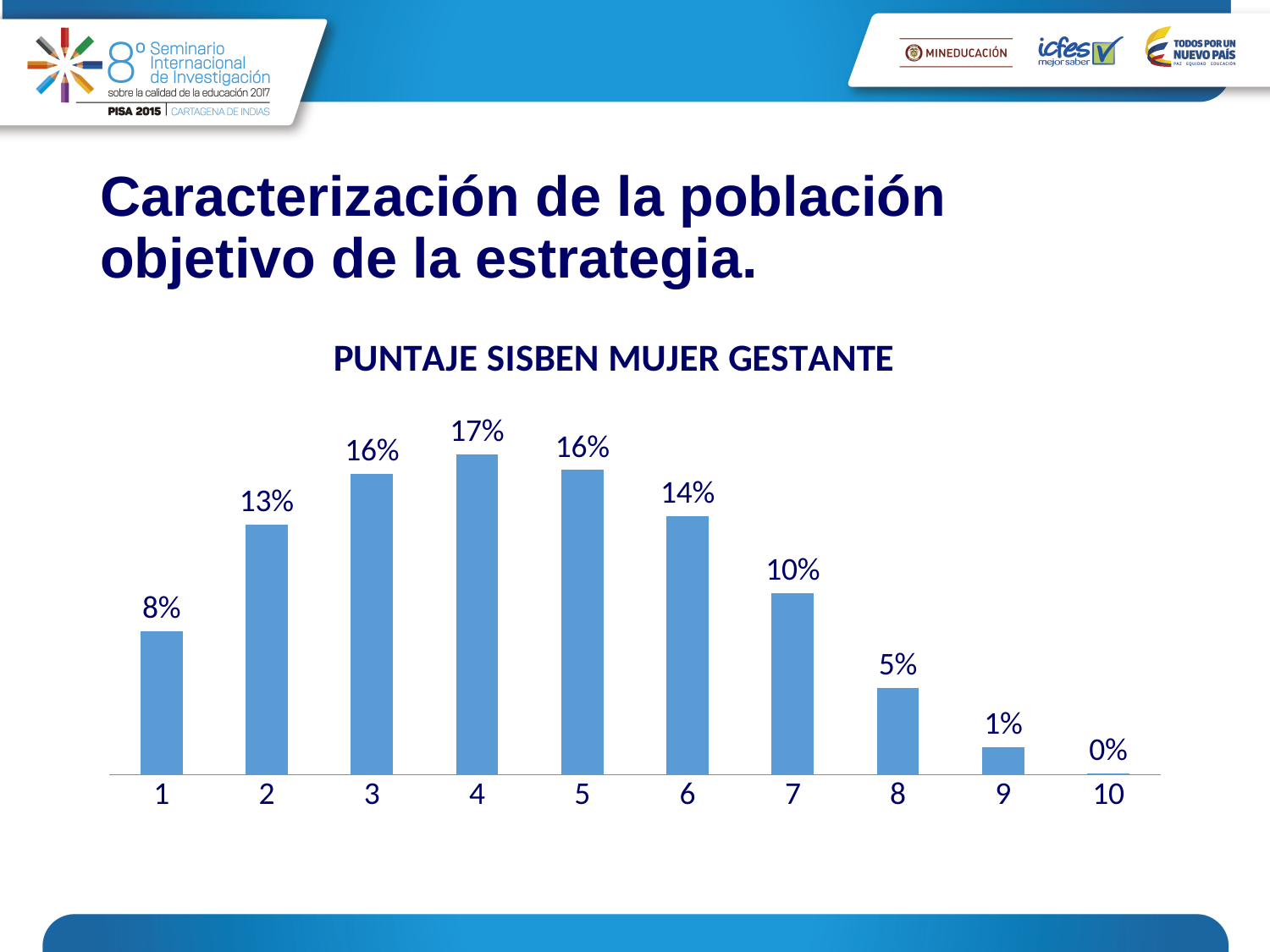
What is the value for category 4? 17% Which category has the lowest value? 10 What is the difference between the values for category 2 and category 9? 12% What is the value for category 8? 5% Do the values rise or fall from category 5 to category 10? fall What is the difference between the values for category 4 and category 7? 7% How many categories are shown on the x axis? 10 What is the title of the chart? PUNTAJE SISBEN MUJER GESTANTE Which category has the highest value? 4 What kind of chart is this? bar chart What is the value for category 1? 8% Which is larger, the value for category 2 or the value for category 6? 6